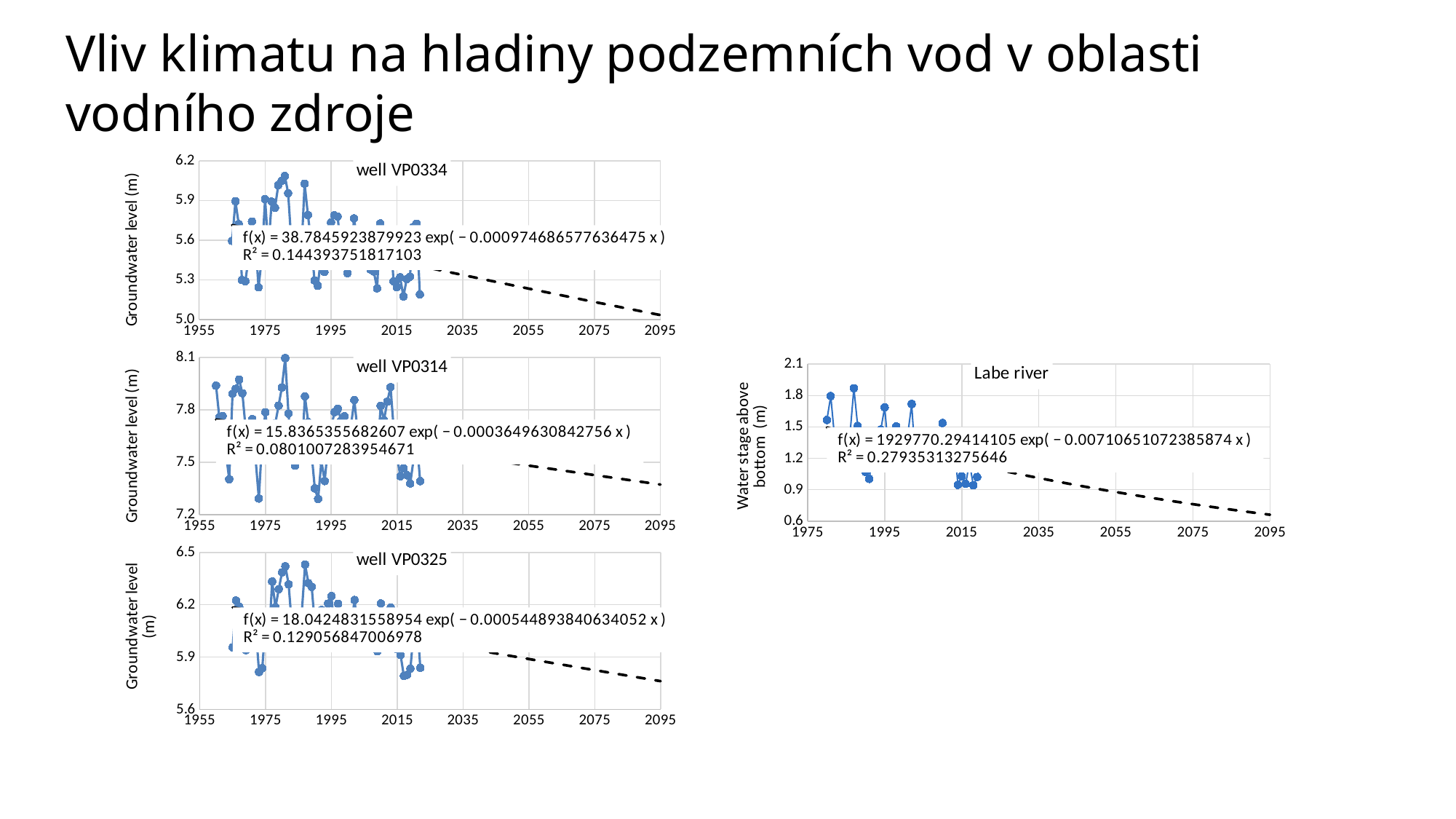
In the 'well VP0314' chart, does the dashed trend line rise or fall toward 2095? fall In the 'well VP0314' chart, is the highest plotted groundwater level greater or less than 7.8? greater In the 'well VP0325' chart, does the dashed trend line rise or fall toward 2095? fall In the 'well VP0325' chart, are the lowest plotted values around 2015 greater or less than 5.9? less In the 'Labe river' chart, are the plotted values around 2015 greater or less than 1.2? less How many charts are shown on the slide? 4 What kind of chart is the 'well VP0334' chart? line chart What is the y-axis label of the 'Labe river' chart? Water stage above bottom (m) In the 'Labe river' chart, does the dashed trend line rise or fall along the x axis? fall What R² value is printed on the 'well VP0334' chart? 0.144393751817103